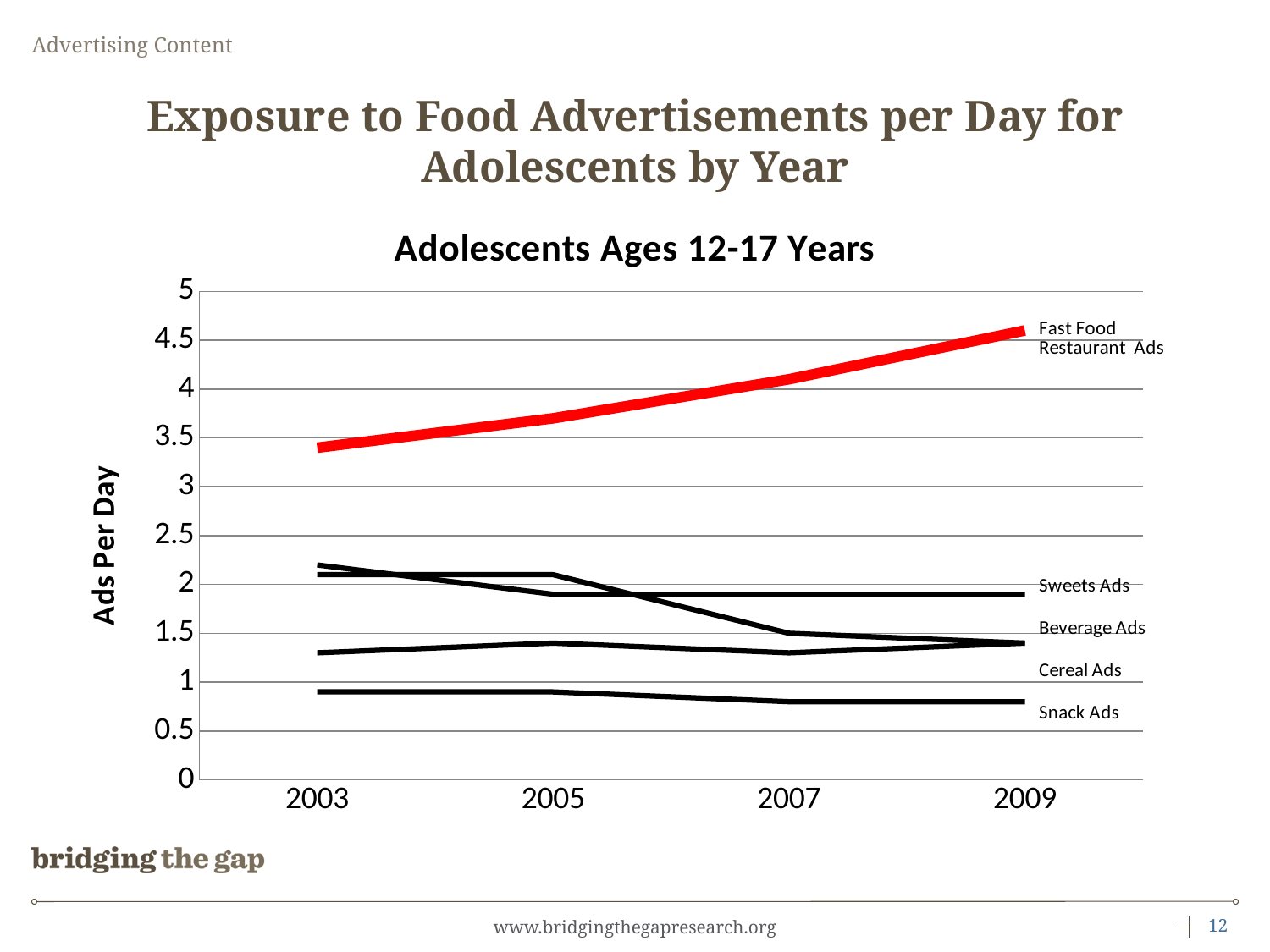
Which series has the highest values across all years? Fast Food Restaurant Ads Which is larger in 2009, the value for Fast Food Restaurant Ads or the value for Snack Ads? Fast Food Restaurant Ads Is the value for Fast Food Restaurant Ads in 2003 greater or less than 3? greater Is the value for Fast Food Restaurant Ads in 2009 greater or less than 4? greater What kind of chart is shown on the slide? line chart What is the label on the y axis? Ads Per Day Do the values for Fast Food Restaurant Ads rise or fall from 2003 to 2009? rise Is the value for Snack Ads in 2009 greater or less than 1? less How many series are labelled on the chart? 5 Which series has the lowest values across all years? Snack Ads How many years are plotted along the x axis? 4 Which series is drawn in red? Fast Food Restaurant Ads